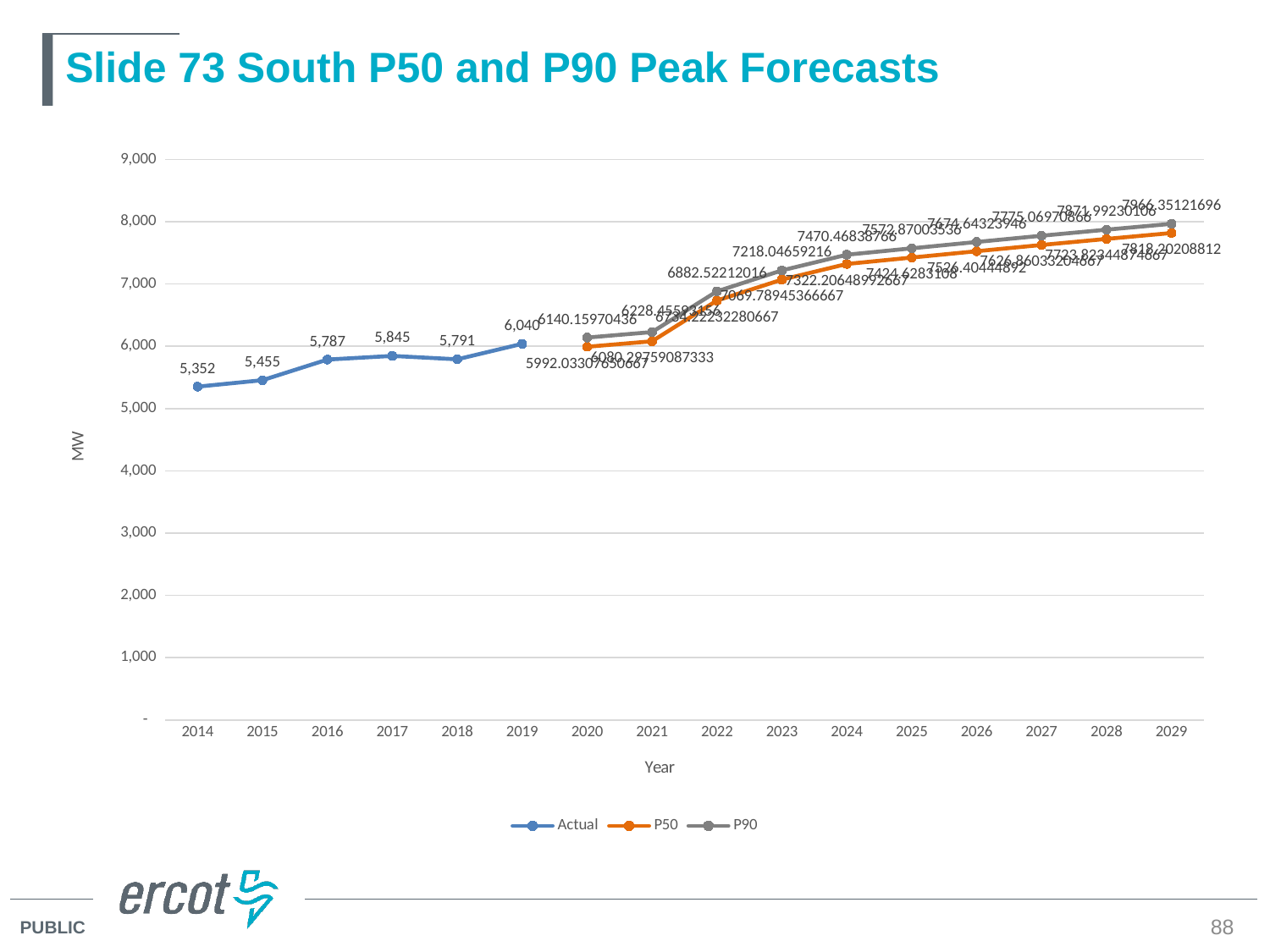
Which year has the lowest Actual value? 2014 Which is larger, the Actual value for 2017 or for 2018? 2017 Is the P90 value for 2029 greater or less than 7,000? greater How many series does the legend list? 3 Which year has the highest Actual value? 2019 What is the difference between the Actual values for 2019 and 2014? 688 Do the P90 values rise or fall from 2020 to 2029? rise What is the Actual value for 2014? 5,352 What is the Actual value for 2017? 5,845 What is the Actual value for 2019? 6,040 What is the P90 value for 2029? 7966.35121696 What kind of chart is shown on the slide? line chart